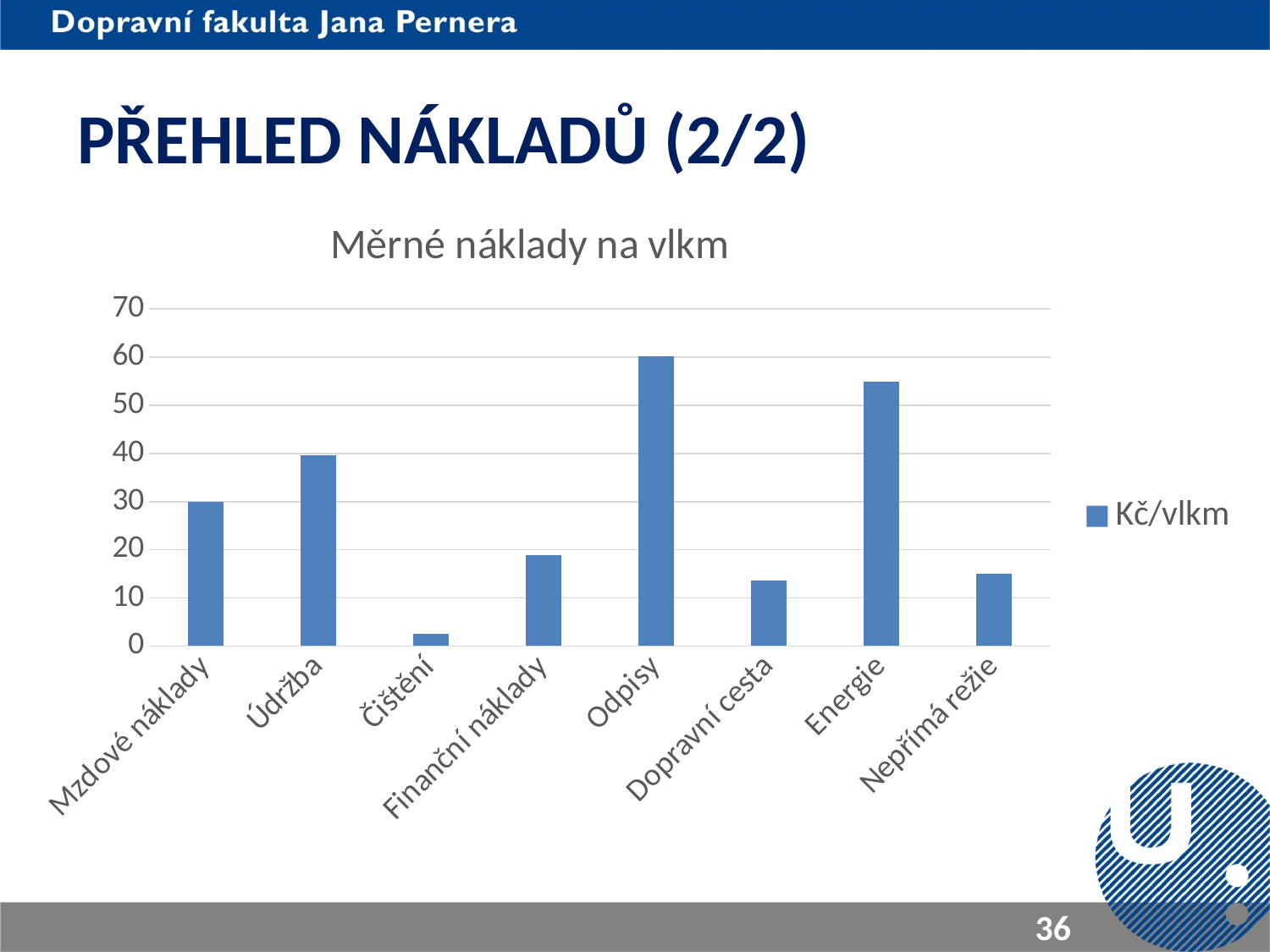
Is the value for Energie greater or less than 50? greater Which is larger, the value for Energie or the value for Údržba? Energie How many series does the legend list? 1 What type of chart is shown on the slide? bar chart Which category has the highest value? Odpisy How many categories are shown on the x axis of the chart? 8 Which category has the lowest value? Čištění Is the value for Finanční náklady greater or less than 20? less What is the legend entry for the series in the chart? Kč/vlkm What is the title of the chart? Měrné náklady na vlkm